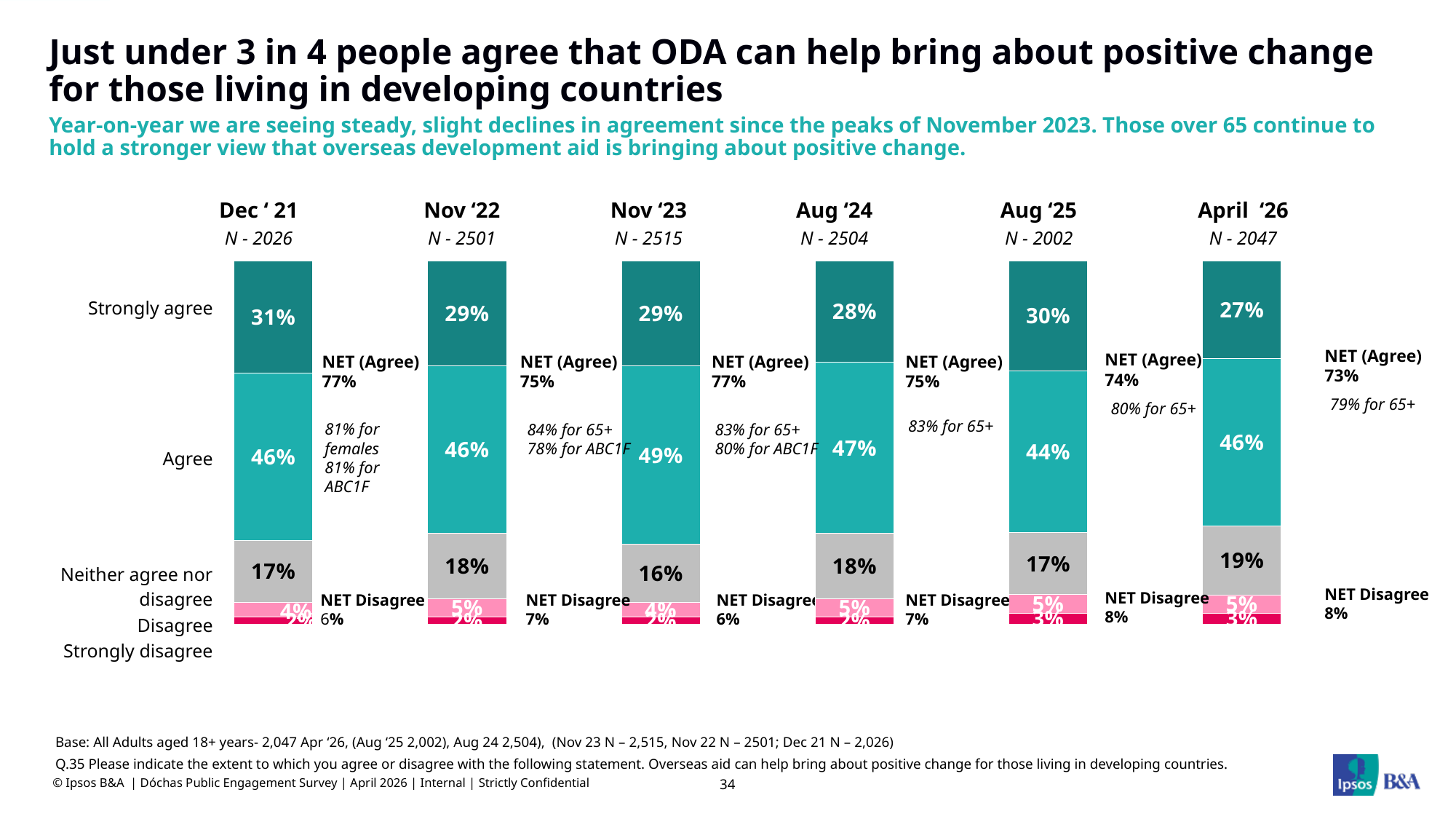
How many survey waves are shown in the chart? 6 Which wave has the highest 'Strongly agree' percentage? Dec '21 What is the difference between the 'Agree' percentage in Nov '23 and in Aug '25? 5% Is the 'Neither agree nor disagree' percentage higher in April '26 or in Nov '23? April '26 What percentage of respondents strongly agree in the April '26 wave? 27% What is the NET (Agree) figure for those aged 65+ in April '26? 79% What is the NET (Agree) figure shown for Aug '25? 74% What type of chart is used on this slide? Stacked bar chart What is the NET Disagree figure shown for April '26? 8% What is the 'Agree' percentage for Nov '23? 49% What is the sample size (N) shown for the Nov '22 wave? 2501 Which wave has the lowest NET (Agree) figure? April '26